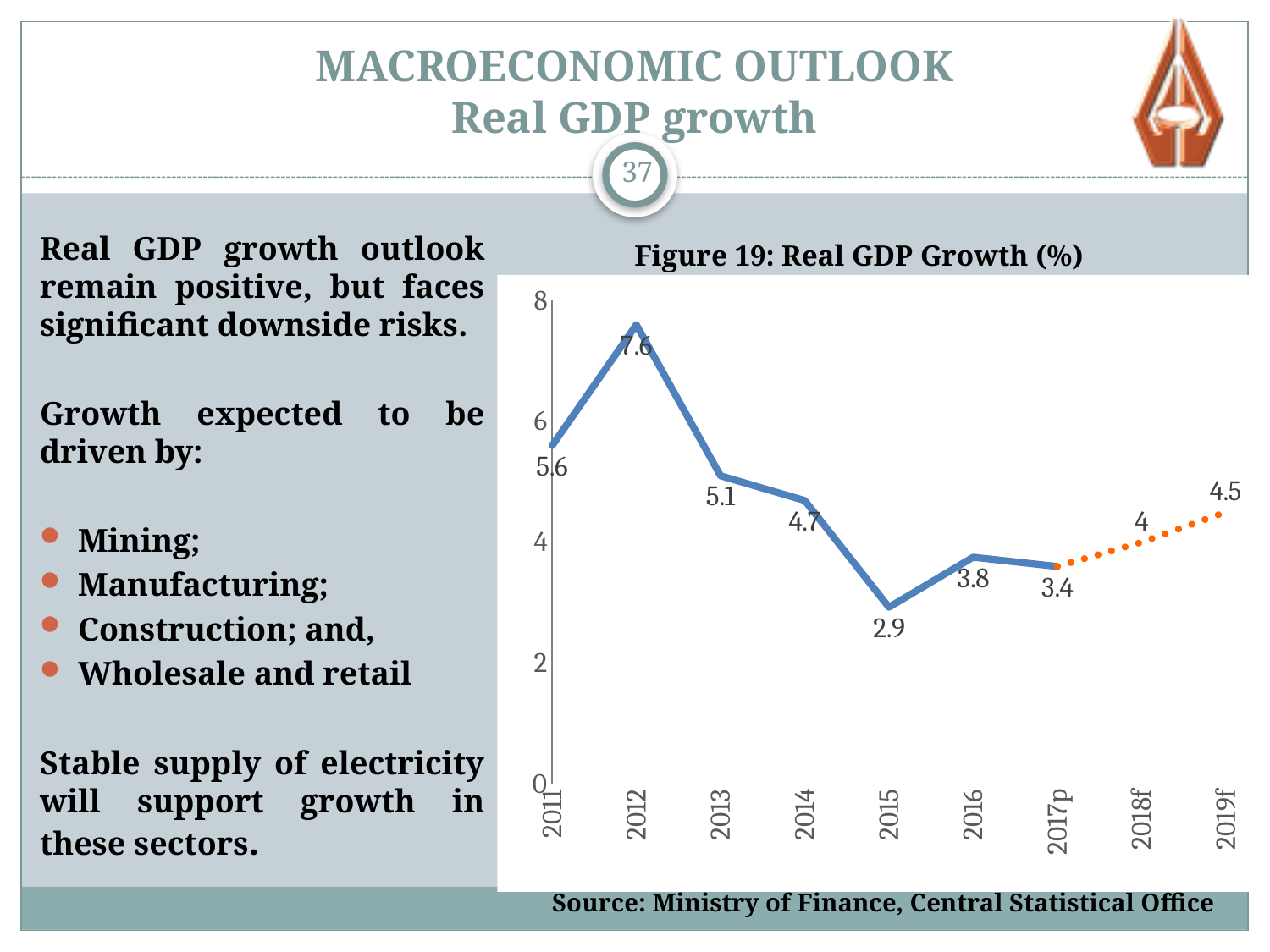
Which year has the lowest Real GDP growth? 2015 What is the Real GDP growth value for 2015? 2.9 What is the Real GDP growth value for 2012? 7.6 What is the difference between the Real GDP growth in 2012 and 2013? 2.5 Which is larger, the Real GDP growth in 2011 or in 2014? 2011 What is the forecast Real GDP growth value for 2019f? 4.5 How many years are shown on the x axis of the chart? 9 What kind of chart is Figure 19? line chart Which year has the highest Real GDP growth? 2012 What is the title of the chart? Figure 19: Real GDP Growth (%) What is the Real GDP growth value for 2017p? 3.4 Is the Real GDP growth value for 2016 greater or less than 4? less